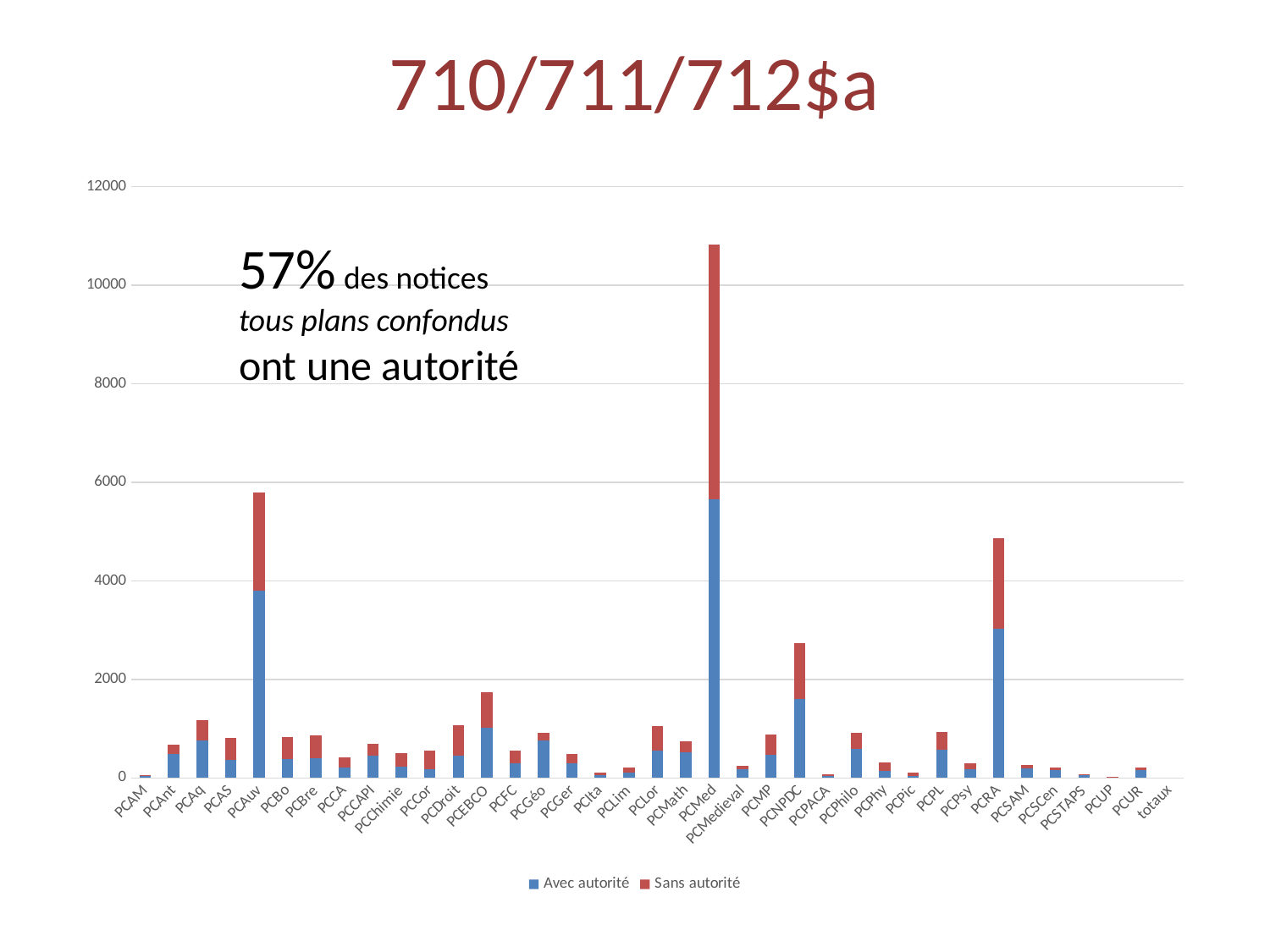
Which has the taller stacked bar, PCNPDC or PCEBCO? PCNPDC Is the total value for PCAuv greater or less than 6000? less Which category has the tallest stacked bar? PCMed Is the total value for PCAuv greater or less than 4000? greater Is the total value for PCNPDC greater or less than 2000? greater What kind of chart is shown on the slide? bar chart How many series does the legend list? 2 Which has the taller stacked bar, PCAuv or PCRA? PCAuv What are the two series named in the legend? Avec autorité and Sans autorité What is the title of the slide? 710/711/712$a